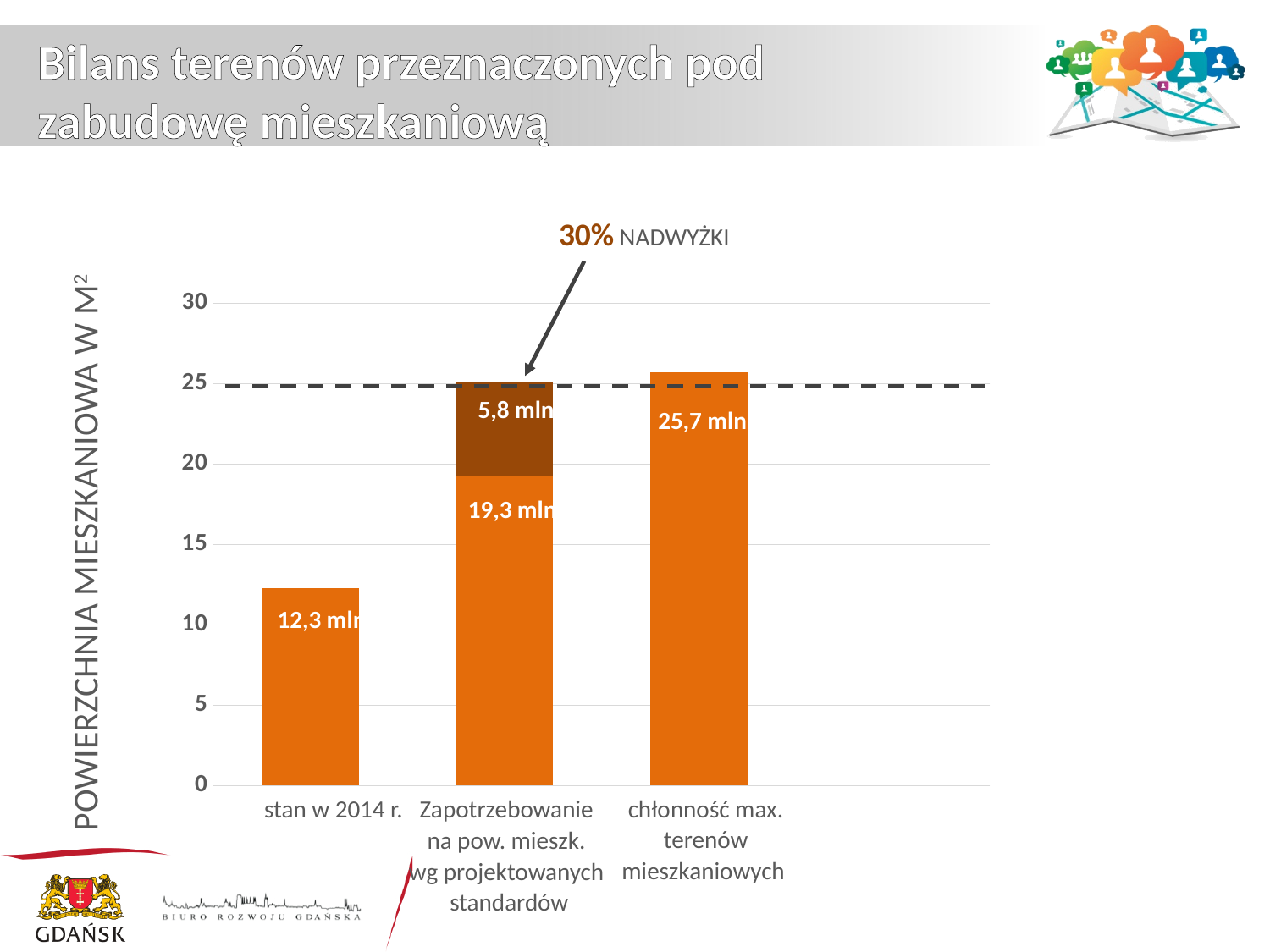
Which category has the lowest value? stan w 2014 r. What is the total of the stacked 'Zapotrzebowanie na pow. mieszk. wg projektowanych standardów' bar? 25,1 mln Which is larger: the value for 'stan w 2014 r.' or the value for 'chłonność max. terenów mieszkaniowych'? chłonność max. terenów mieszkaniowych How many categories are shown on the x axis of the chart? 3 What is the value of the lower (orange) segment of the 'Zapotrzebowanie na pow. mieszk. wg projektowanych standardów' bar? 19,3 mln What is the value of the upper (dark brown) segment of the 'Zapotrzebowanie na pow. mieszk. wg projektowanych standardów' bar? 5,8 mln What type of chart is shown on the slide? bar chart What percentage surplus ('NADWYŻKI') is annotated above the chart? 30% What is the label of the vertical axis? POWIERZCHNIA MIESZKANIOWA W M² What is the value for 'stan w 2014 r.'? 12,3 mln What is the difference between 'chłonność max. terenów mieszkaniowych' and 'stan w 2014 r.'? 13,4 mln What is the value for 'chłonność max. terenów mieszkaniowych'? 25,7 mln